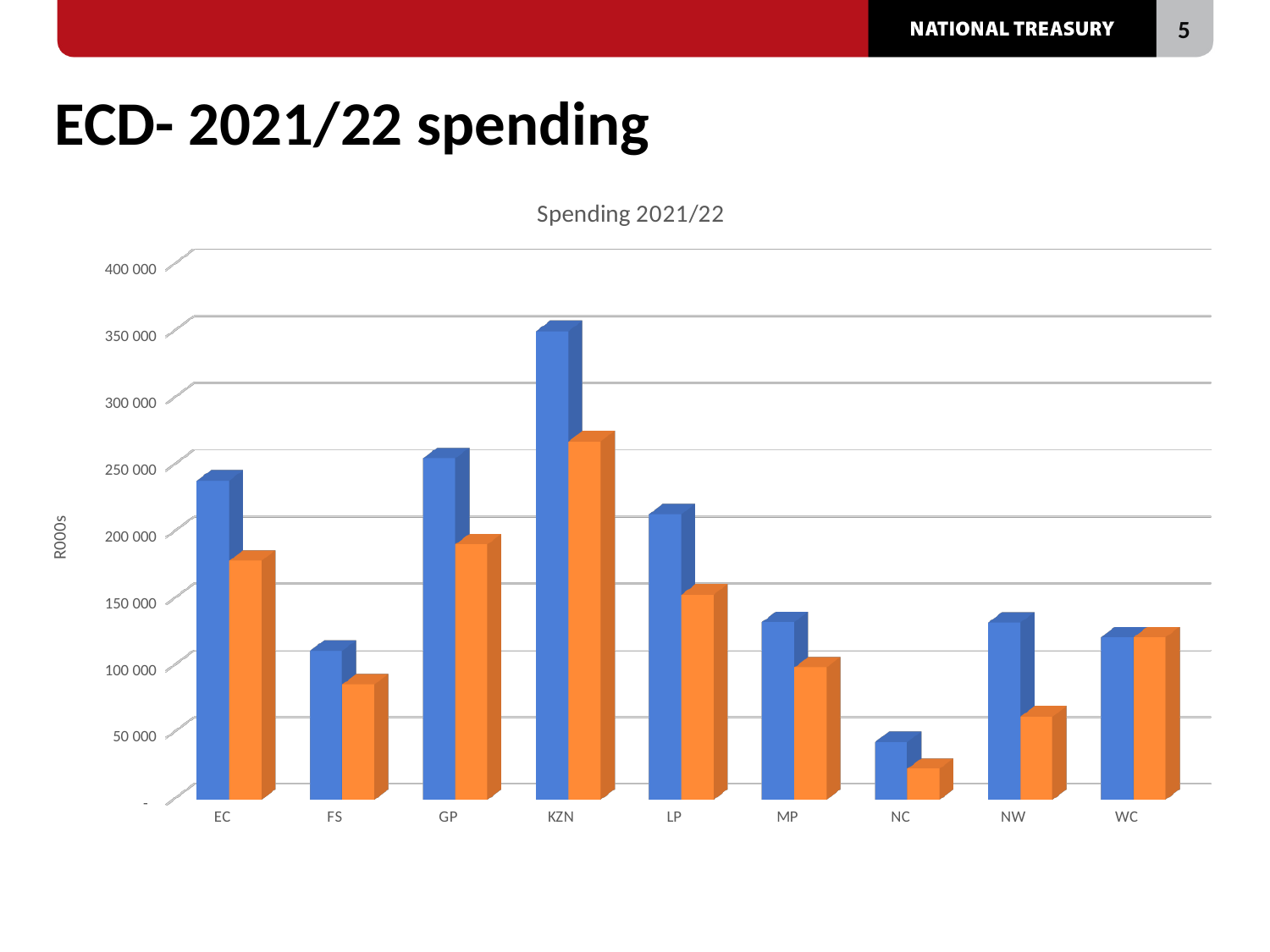
What is the label on the vertical axis of the chart? R000s Is the orange bar for NW greater or less than 100 000? less Which province has the highest orange bar? KZN Which is larger, the blue bar for KZN or the blue bar for GP? KZN How many provinces (categories) are shown on the x axis? 9 Which province has the lowest blue bar? NC What kind of chart is shown on the slide? bar chart Is the orange bar for NC greater or less than 50 000? less Is the blue bar for KZN greater or less than 300 000? greater What is the title of the chart? Spending 2021/22 How many bars are plotted for each province? 2 Which province has the highest blue bar? KZN